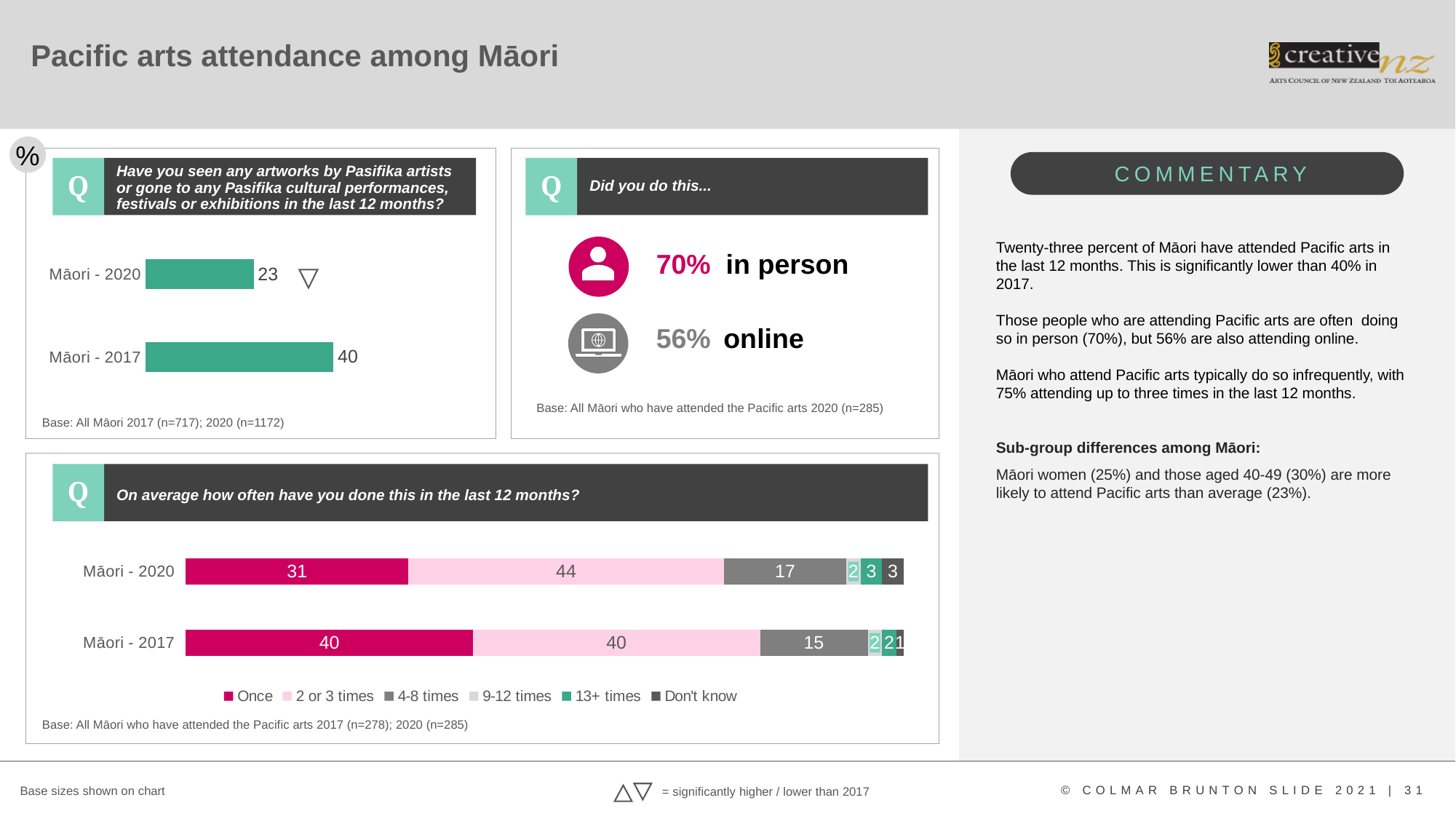
In the bottom chart on how often people attended, what is the difference between the 'Once' values for Māori - 2017 and Māori - 2020? 9 In the bottom chart on how often people attended, what is the value for '4-8 times' for Māori - 2020? 17 In the bottom chart on how often people attended, which segment is the largest for Māori - 2020? 2 or 3 times In the bottom chart on how often people attended, what is the value for '2 or 3 times' for Māori - 2017? 40 In the top-left chart on Pasifika arts attendance, what is the value for Māori - 2017? 40 In the top-left chart on Pasifika arts attendance, what is the difference between the Māori - 2017 and Māori - 2020 values? 17 What kind of chart is the top-left chart on Pasifika arts attendance? Bar chart In the top-left chart on Pasifika arts attendance, what is the value for Māori - 2020? 23 In the bottom chart on how often people attended, what is the value for 'Once' for Māori - 2020? 31 In the top-left chart on Pasifika arts attendance, which year has the higher value? Māori - 2017 In the bottom chart on how often people attended, what is the total of the Māori - 2020 stacked bar? 100 In the bottom chart on how often people attended, how many series does the legend list? 6